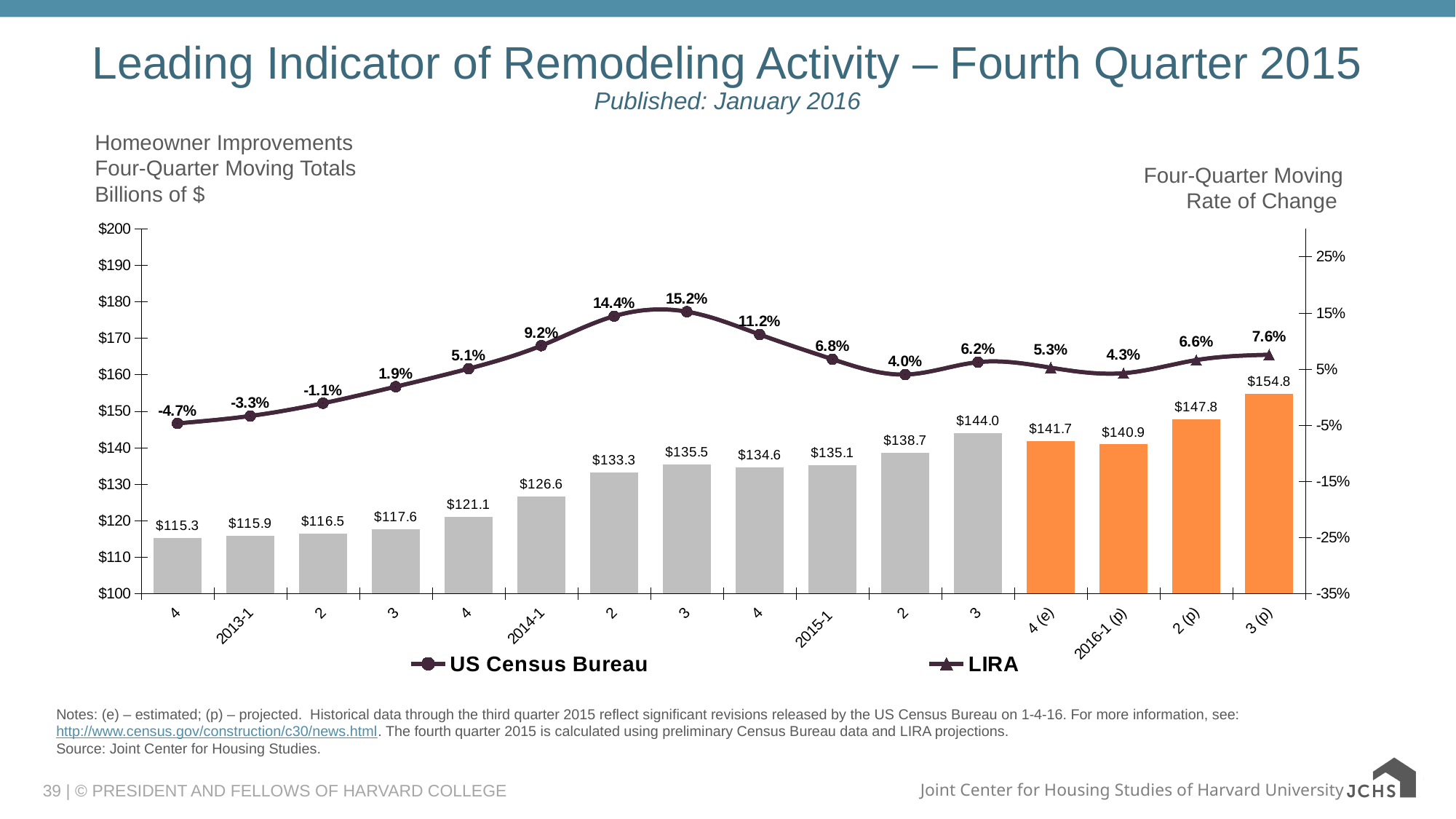
How many bars (quarters) are plotted in the chart? 16 What is the projected four-quarter moving total for 3 (p) of 2016? $154.8 What is the four-quarter moving total for 2015-1? $135.1 Which quarter has the lowest four-quarter moving total? 4 (2012) Which quarter has the highest four-quarter moving rate of change? 3 (2014) Which is larger, the four-quarter moving total for 3 of 2015 or for 4 (e) of 2015? 3 of 2015 ($144.0) Do the four-quarter moving totals generally rise or fall from 4 (2012) to 3 (p) of 2016? Rise What are the two series named in the legend? US Census Bureau and LIRA What is the four-quarter moving rate of change for 2014-1? 9.2% What is the difference between the four-quarter moving totals for 2 (p) and 2016-1 (p)? $6.9 What kind of chart is shown on the slide? Combination bar and line chart How many series does the legend list? 2